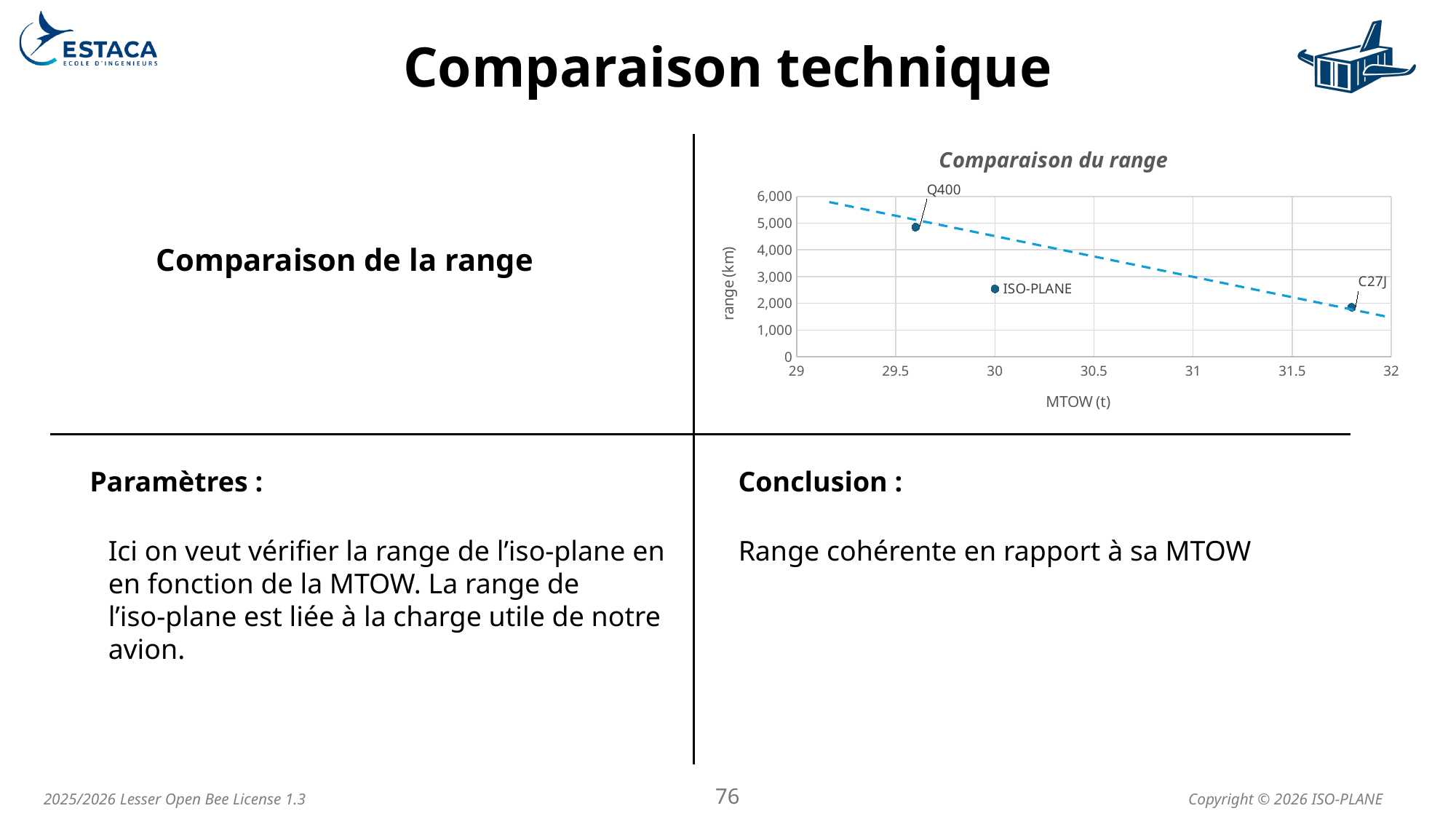
Which aircraft has the lowest range on the chart? C27J What kind of chart is shown on the slide? scatter chart Is the range value for ISO-PLANE greater or less than 2,000 km? greater Does the dashed trend line rise or fall as MTOW increases? fall Which has the larger range, Q400 or ISO-PLANE? Q400 How many labelled data points are plotted on the chart? 3 Which has the larger MTOW, C27J or Q400? C27J What is the title of the chart? Comparaison du range Which aircraft has the highest range on the chart? Q400 Is the range value for Q400 greater or less than 4,000 km? greater Is the range value for C27J greater or less than 3,000 km? less What is the label of the horizontal axis of the chart? MTOW (t)